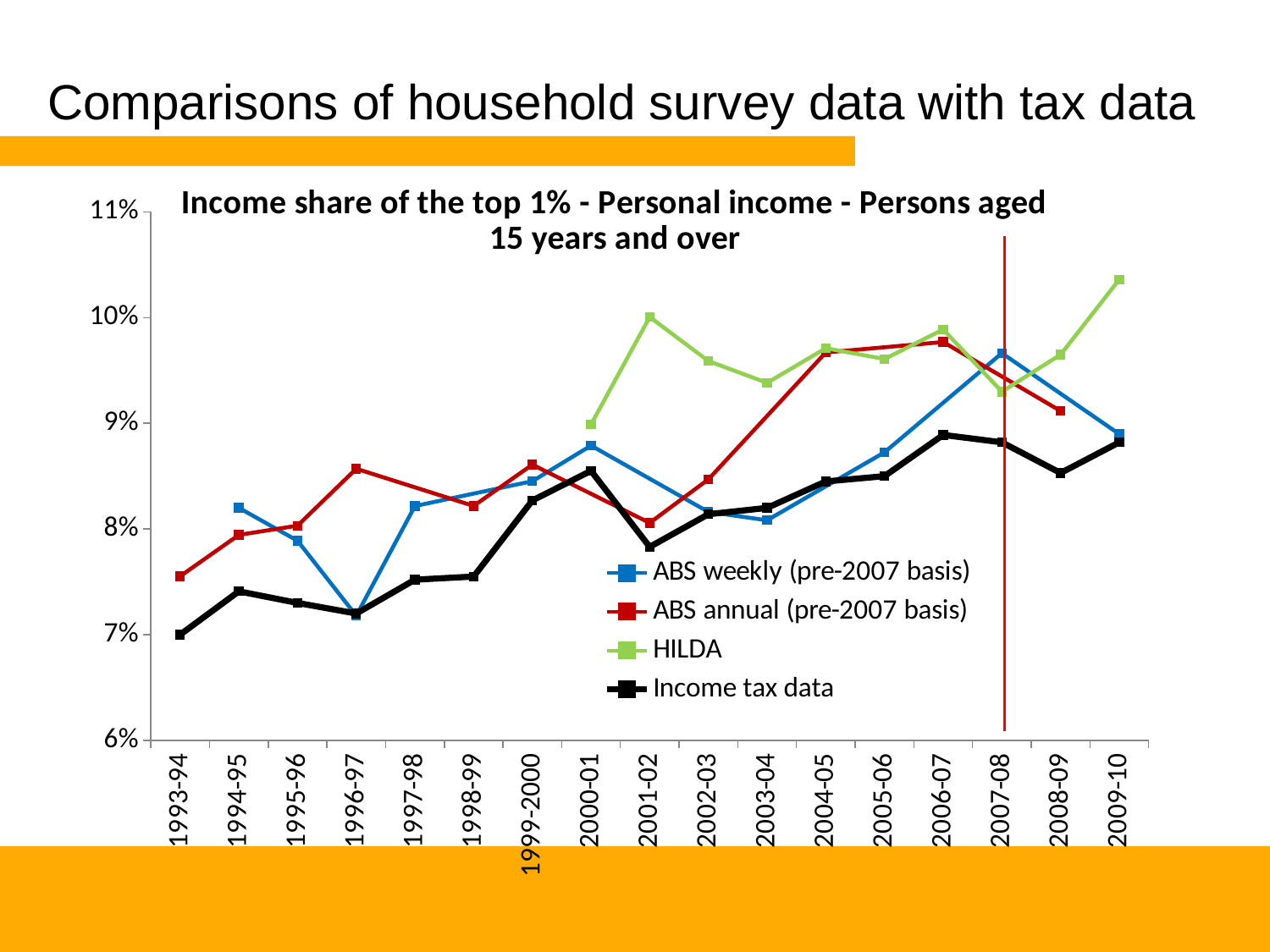
In 1996-97, which is larger: ABS annual (pre-2007 basis) or ABS weekly (pre-2007 basis)? ABS annual (pre-2007 basis) How many series does the legend list? 4 Which series has the highest value in 2009-10? HILDA Is the ABS weekly (pre-2007 basis) value for 2007-08 greater or less than 9%? greater Is the Income tax data value for 1993-94 greater or less than 8%? less What kind of chart is shown on the slide? Line chart In 2009-10, which is larger: HILDA or Income tax data? HILDA Is the HILDA value for 2009-10 greater or less than 10%? greater Does the Income tax data series generally rise or fall from 1993-94 to 2009-10? Rise How many financial years are shown on the x axis? 17 In which year is the ABS weekly (pre-2007 basis) series at its lowest? 1996-97